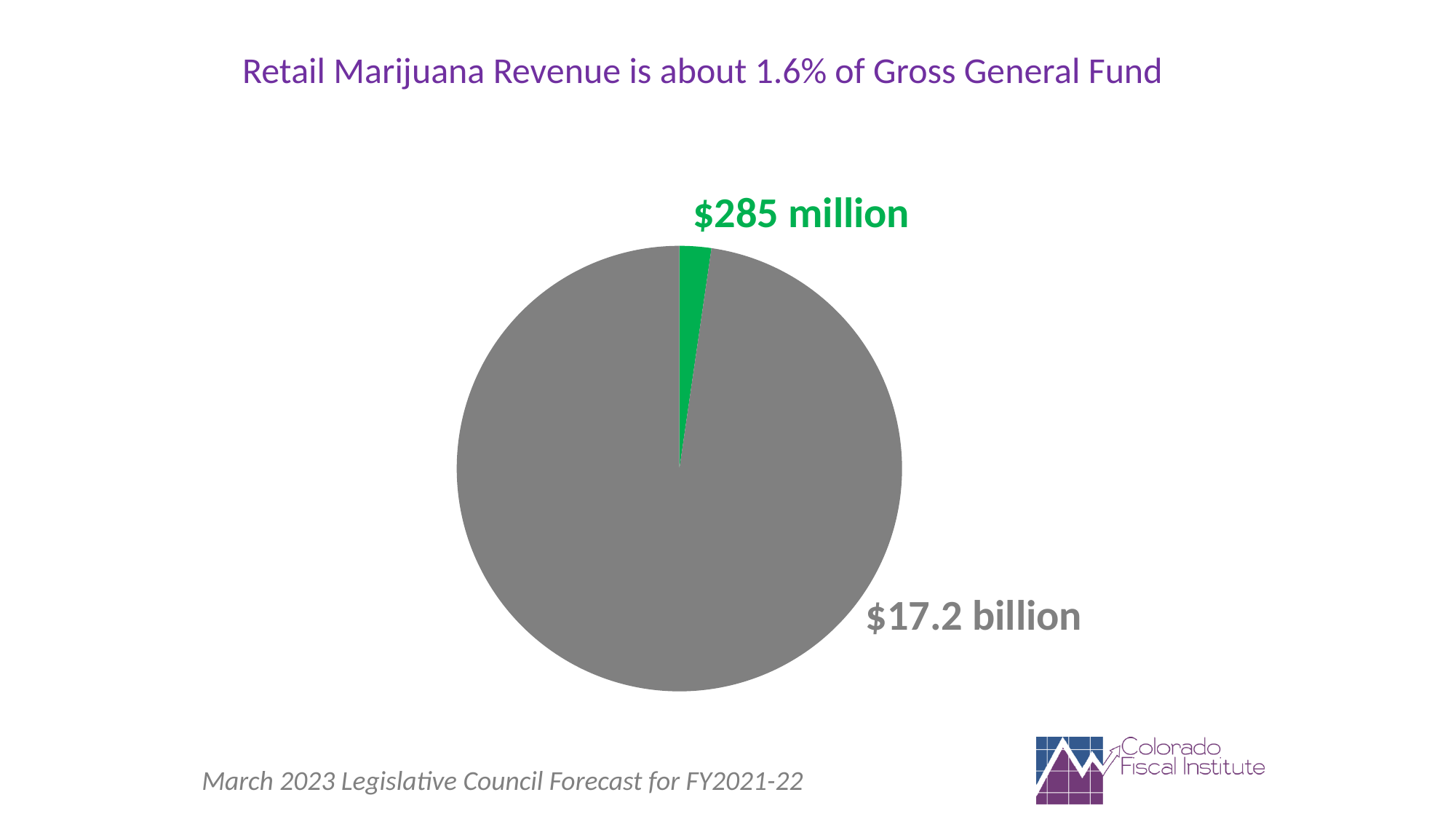
What value is labelled on the gray slice of the pie chart? $17.2 billion Which slice of the pie chart is the largest? $17.2 billion Is the value of the green slice greater or less than $1 billion? less According to the slide title, what share of the Gross General Fund is Retail Marijuana Revenue? about 1.6% What is the title of the chart on the slide? Retail Marijuana Revenue is about 1.6% of Gross General Fund How many slices does the pie chart have? 2 What value is labelled on the green slice of the pie chart? $285 million What kind of chart is shown on the slide? Pie chart Which slice of the pie chart is the smallest? $285 million Which is larger, the green slice or the gray slice? The gray slice